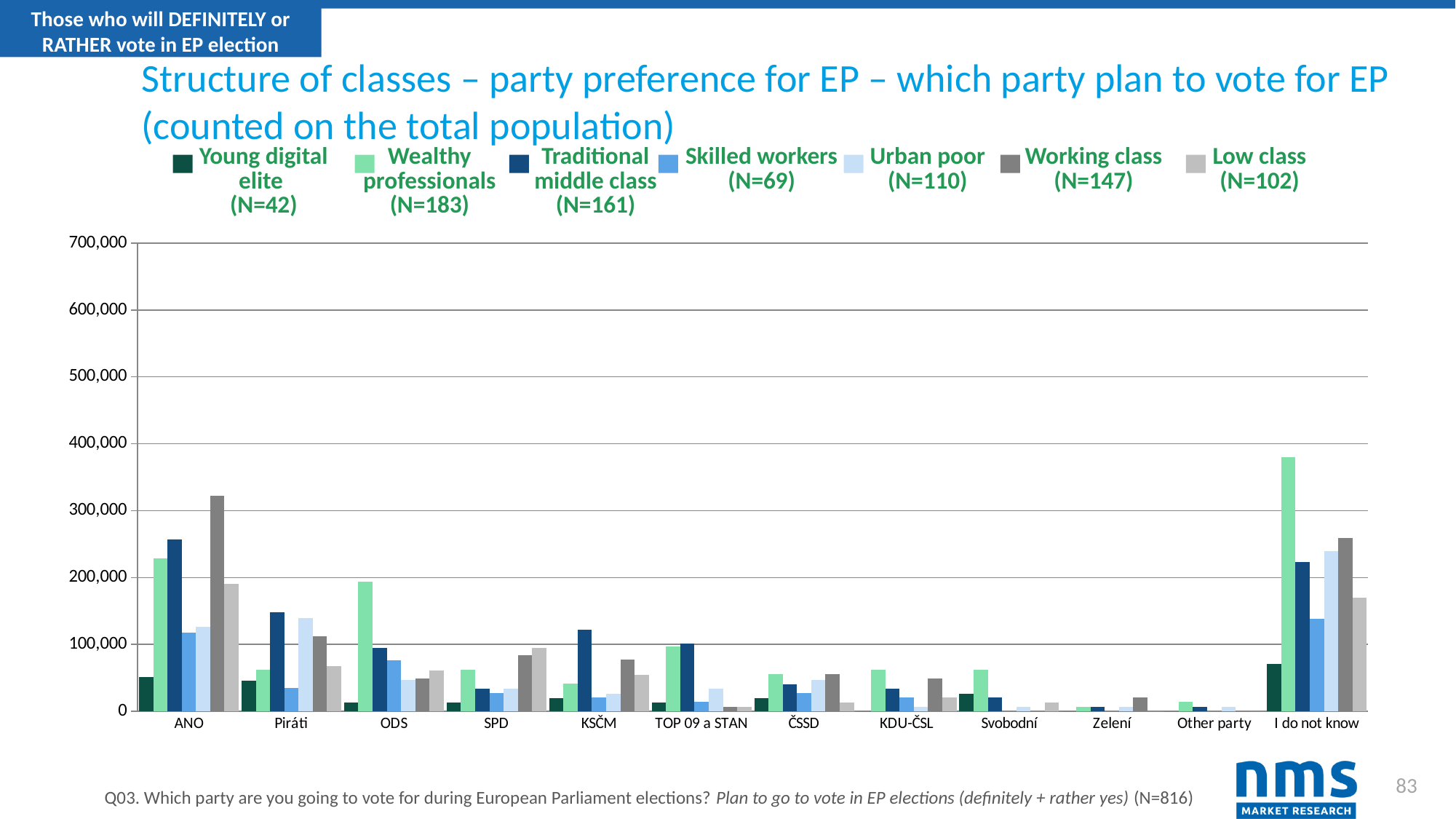
Is the Wealthy professionals value for ODS greater or less than 100,000? greater Which class has the highest bar for ANO? Working class (N=147) What kind of chart is shown on the slide? bar chart For Piráti, which is larger: Traditional middle class or Skilled workers? Traditional middle class What sample size (N) does the legend give for the Working class series? N=147 Which class has the highest bar for KSČM? Traditional middle class (N=161) Is the Working class value for ANO greater or less than 300,000? greater For which party category is the Wealthy professionals bar the highest? I do not know How many series does the legend list? 7 For ODS, which is larger: Wealthy professionals or Traditional middle class? Wealthy professionals Is the Wealthy professionals value for 'I do not know' greater or less than 400,000? less How many party categories are shown along the x axis? 12